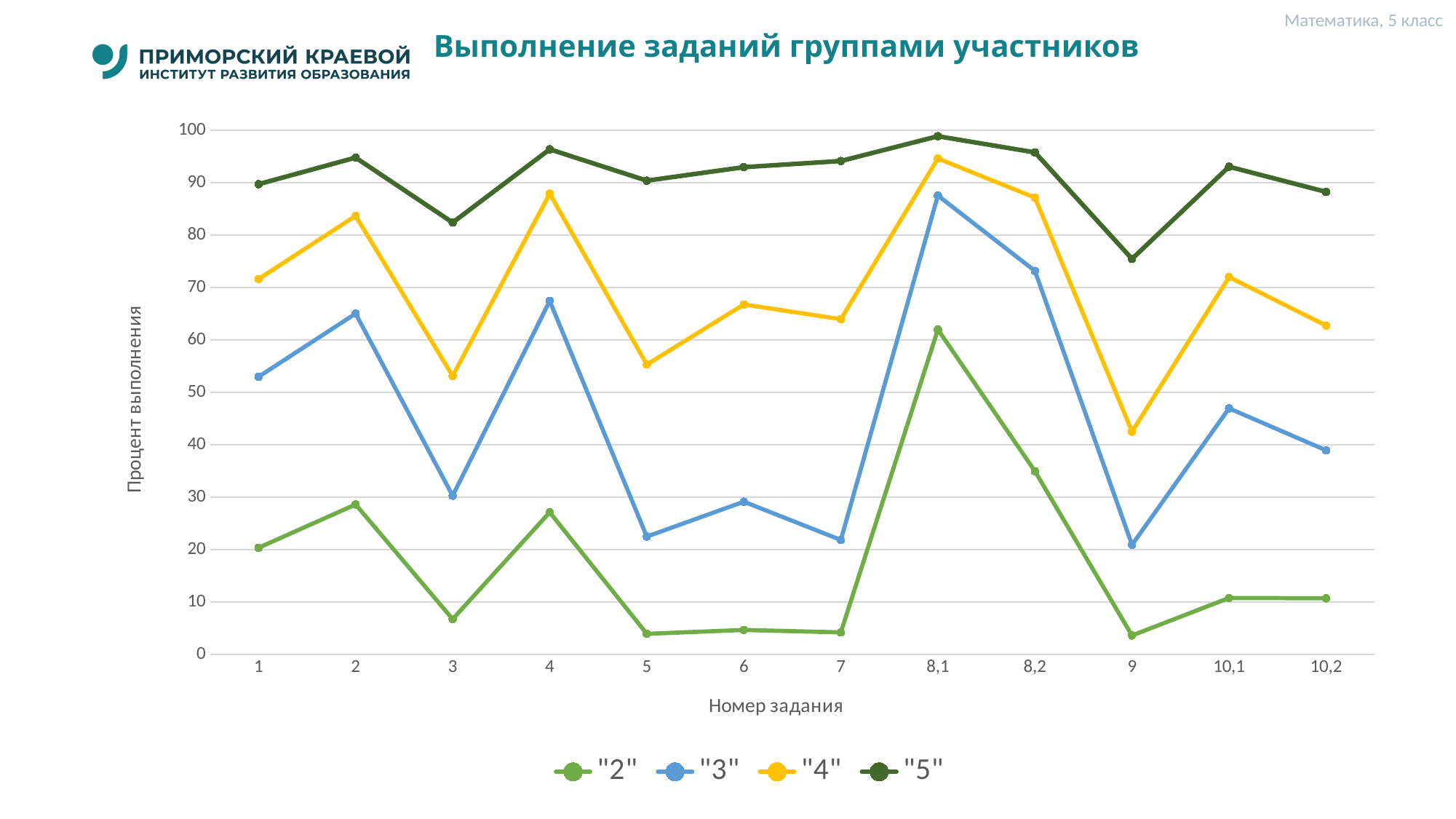
How many series does the legend list? 4 What kind of chart is shown on the slide? line chart Is the value for the "2" series at task 5 greater or less than 10? less What is the title of the vertical axis? Процент выполнения Is the value for the "5" series at task 9 greater or less than 80? less For which task number does the "4" series reach its lowest value? 9 Is the value for the "3" series at task 8,1 greater or less than 80? greater How many task numbers are shown along the x axis? 12 For the "4" series, which is larger: the value at task 2 or the value at task 3? task 2 For which task number does the "5" series reach its lowest value? 9 For which task number does the "2" series reach its highest value? 8,1 Does the "3" series rise or fall from task 8,1 to task 9? fall